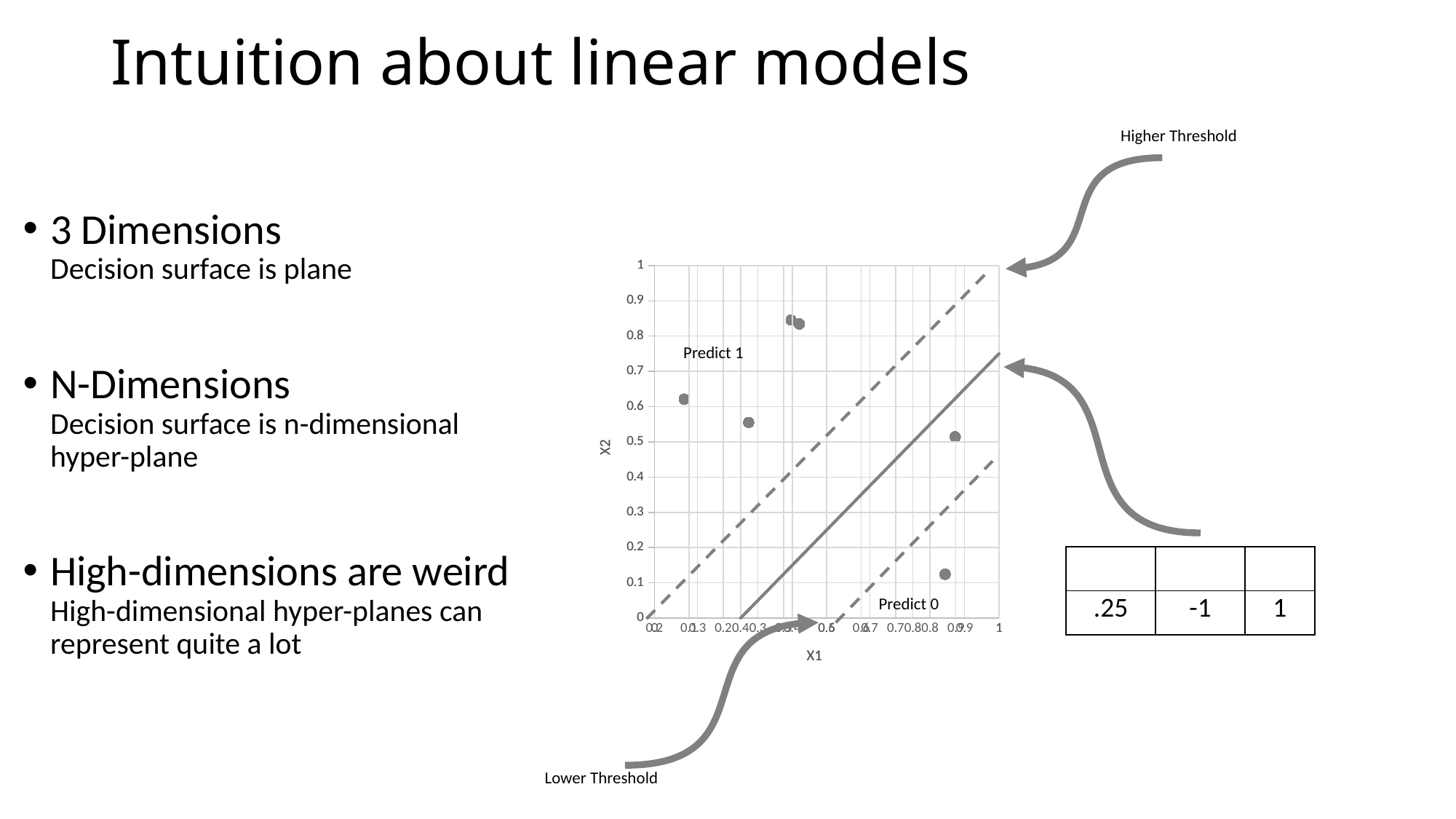
Is the X2 value of the lowest point (near X1 = 0.85) greater or less than 0.2? less Which has the larger X2 value: the point near X1 = 0.9 at the top or the point near X1 = 0.85 at the bottom? the point near X1 = 0.9 at the top Is the X1 value of the lowest point on the chart greater or less than 0.5? greater What is the label of the vertical axis of the chart? X2 What is the maximum value shown on the X2 axis of the chart? 1 Is the X2 value of the leftmost point (near X1 = 0.1) greater or less than 0.5? greater Which has the larger X2 value: the point near X1 = 0.1 or the point near X1 = 0.3? the point near X1 = 0.1 What is the label of the horizontal axis of the chart? X1 What kind of chart is shown on the slide? scatter chart